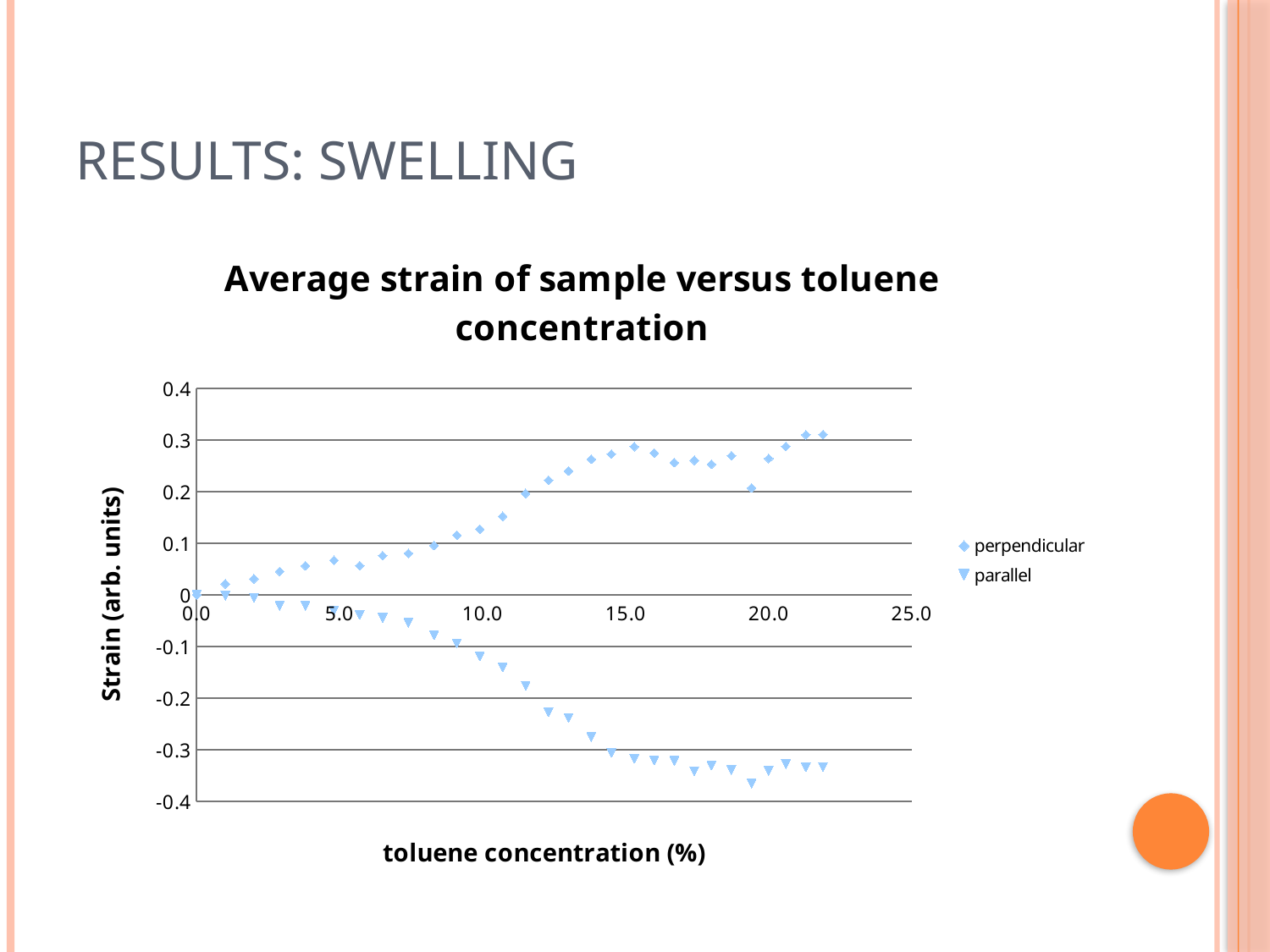
What kind of chart is shown on the slide? scatter chart Is the parallel strain at a toluene concentration of 15.0 greater or less than -0.2? less How many series does the legend list? 2 Does the strain for the perpendicular series rise or fall as toluene concentration increases? rise What are the two series named in the legend? perpendicular and parallel Is the perpendicular strain at a toluene concentration of 20.0 greater or less than 0.2? greater At a toluene concentration of 20.0, which series has the higher strain, perpendicular or parallel? perpendicular Does the strain for the parallel series rise or fall as toluene concentration increases? fall Is the parallel strain at a toluene concentration of 20.0 greater or less than -0.3? less What is the title of the chart? Average strain of sample versus toluene concentration Which series reaches the highest strain value on the chart? perpendicular